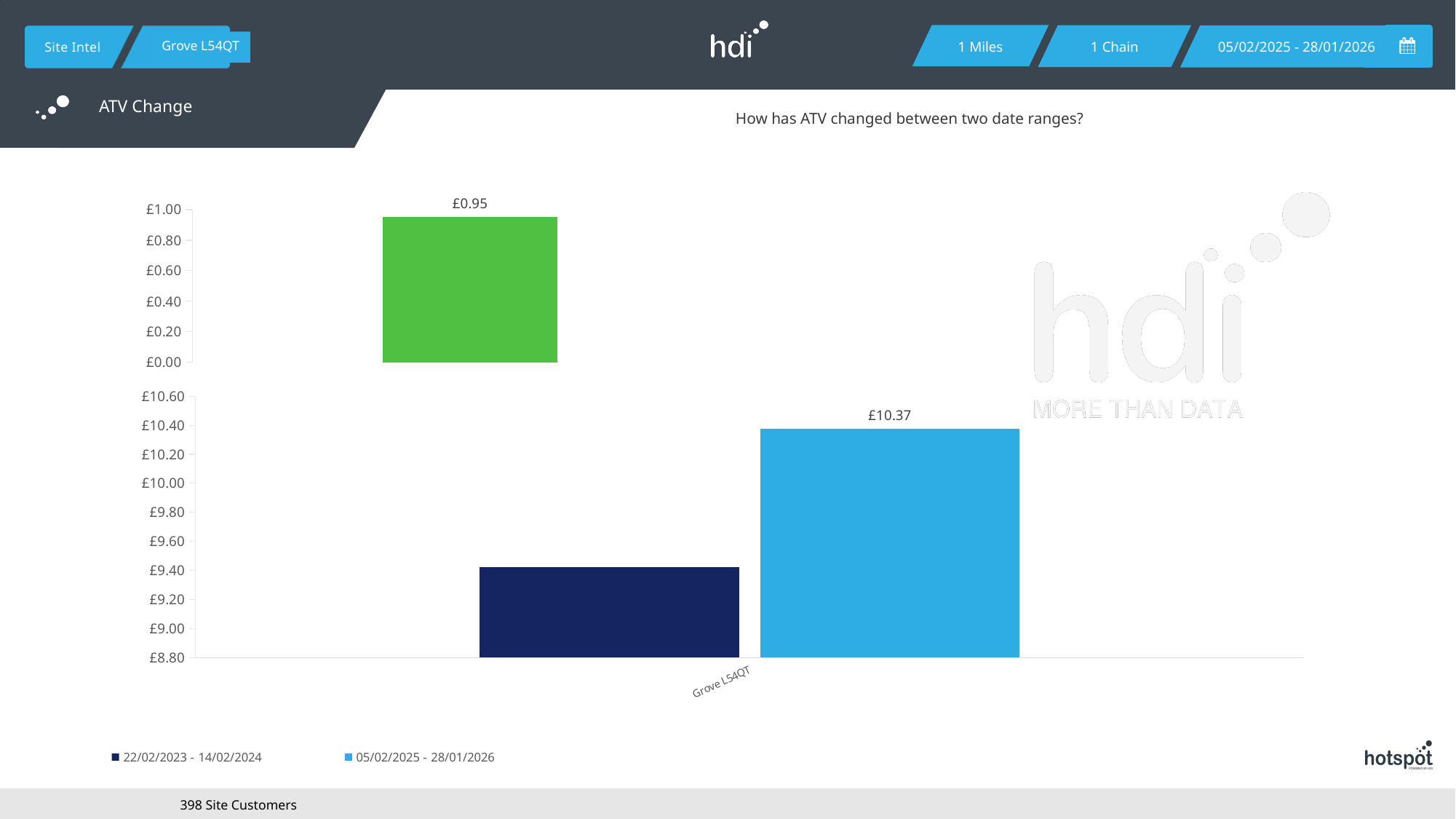
In the bottom chart, which period has the higher ATV for Grove L54QT? 05/02/2025 - 28/01/2026 In the top chart, what is the value shown on the green bar? £0.95 In the top chart, is the value of the green bar greater or less than £0.80? greater In the bottom chart, what is the ATV value for Grove L54QT in the 05/02/2025 - 28/01/2026 period? £10.37 How many series does the legend at the bottom of the slide list? 2 In the bottom chart, is the value for the 22/02/2023 - 14/02/2024 period greater or less than £9.20? greater What is the title of the slide's chart section? ATV Change In the bottom chart, is the value for the 22/02/2023 - 14/02/2024 period greater or less than £9.60? less How many bars are plotted in the bottom chart? 2 What type of chart is the bottom chart? bar chart What is the category label on the x axis of the bottom chart? Grove L54QT